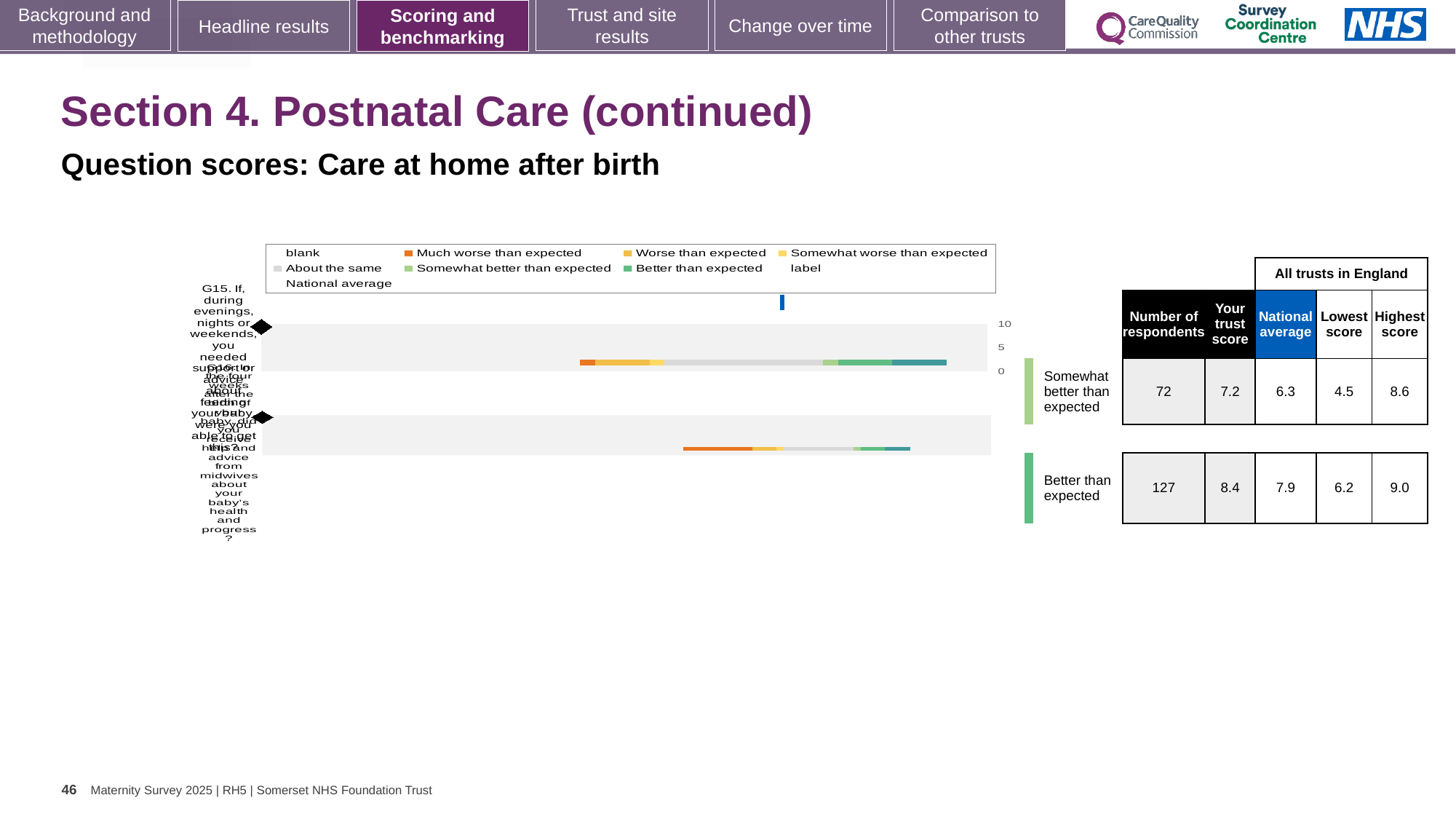
What kind of chart is shown on the slide? bar chart What colour does the legend use for 'Much worse than expected'? orange In the table next to the chart, what is the trust score for the question rated 'Somewhat better than expected'? 7.2 In the table next to the chart, what is the national average for the question rated 'Better than expected'? 7.9 What is the difference between the highest and lowest scores for the question rated 'Better than expected'? 2.8 By how much does the trust score exceed the national average for the question rated 'Somewhat better than expected'? 0.9 In the table next to the chart, what is the highest score for the question rated 'Better than expected'? 9.0 Which question has the higher trust score: the one rated 'Somewhat better than expected' or the one rated 'Better than expected'? Better than expected According to the legend, what does the blue vertical marker on the chart represent? National average In the table next to the chart, how many respondents are there for the question rated 'Better than expected'? 127 How many questions (bars) are plotted in the chart? 2 In the table next to the chart, what is the lowest score for the question rated 'Somewhat better than expected'? 4.5